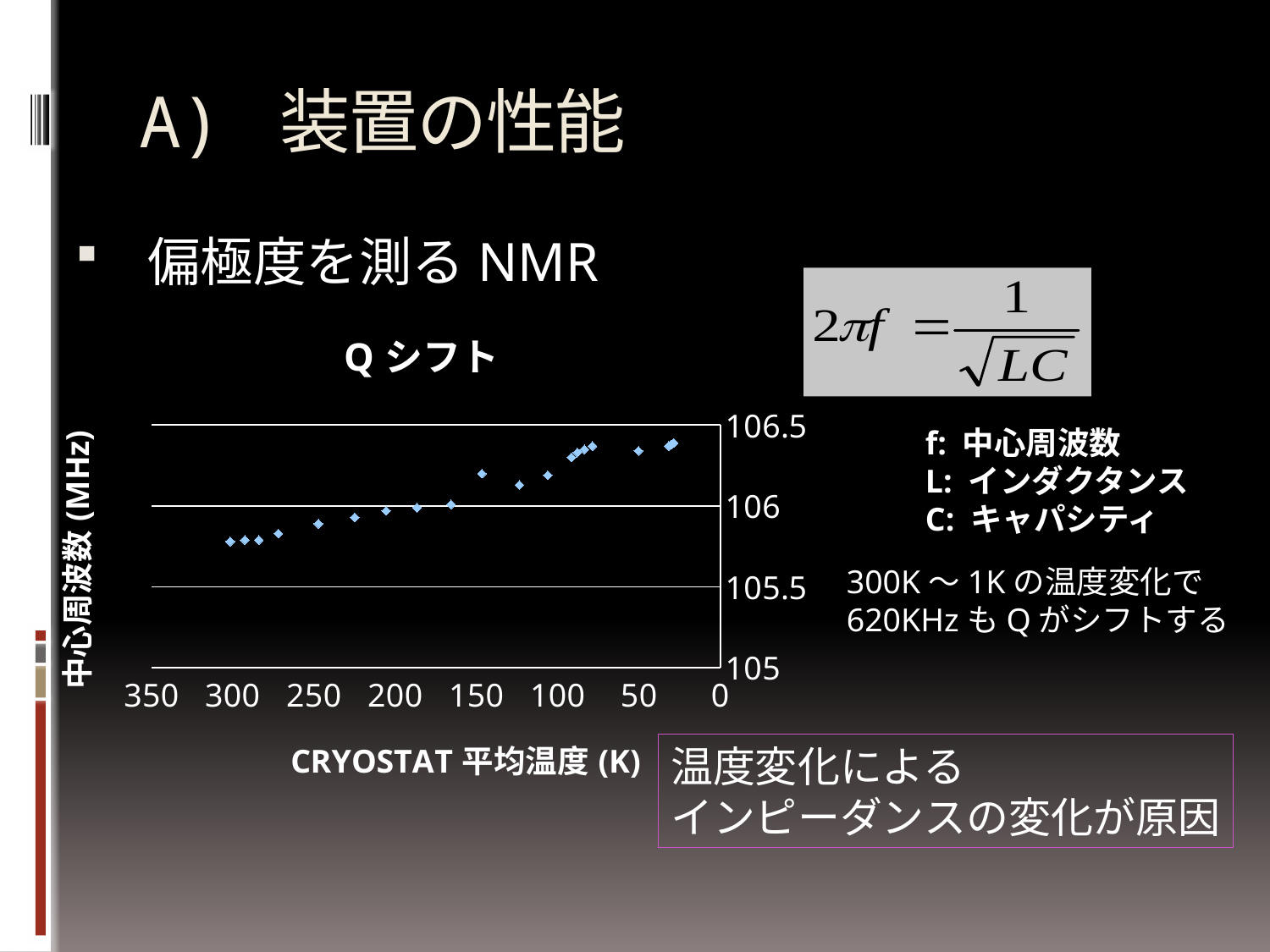
What is the label of the x axis of the chart? CRYOSTAT 平均温度 (K) Which has the higher center frequency: the point near 300 K or the point near 50 K? the point near 50 K Is the center frequency at a cryostat temperature of about 50 K greater or less than 106 MHz? greater Is the center frequency at a cryostat temperature of about 300 K greater or less than 106 MHz? less Is the center frequency at a cryostat temperature of about 300 K greater or less than 105.5 MHz? greater At which end of the temperature axis are the lowest center frequency values found, near 300 K or near 0 K? near 300 K What is the title of the chart on the slide? Q シフト Moving from left to right along the x axis (from 350 K toward 0 K), do the plotted center frequency values rise or fall? rise Which has the lower center frequency: the point near 250 K or the point near 100 K? the point near 250 K What kind of chart is shown on the slide? scatter chart